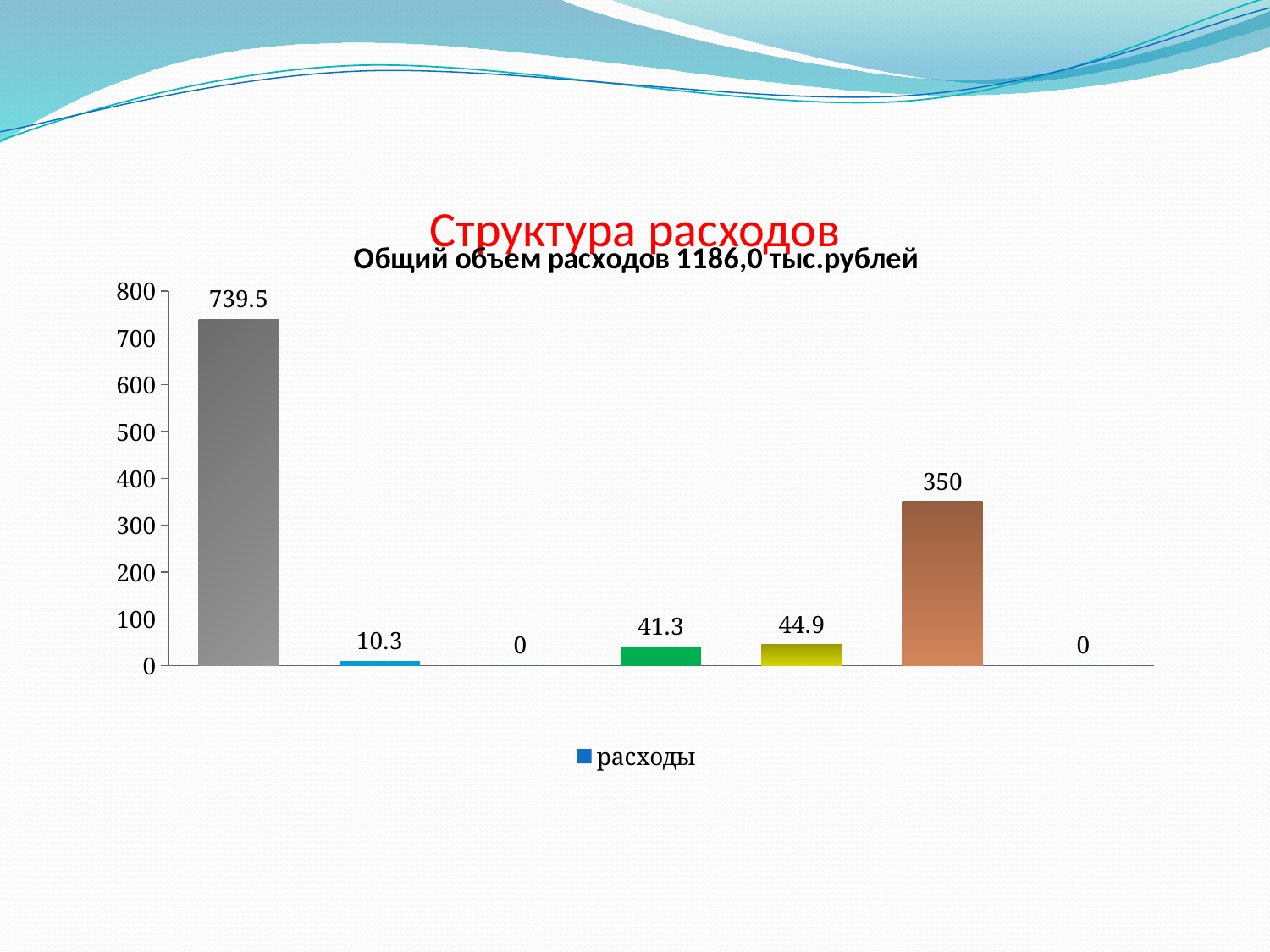
Which is larger, the fourth (green) bar or the fifth (yellow) bar? the fifth (yellow) bar, 44.9 What is the value of the fifth (yellow) bar? 44.9 What is the value of the first (grey) bar? 739.5 What is the difference between the first bar (739.5) and the sixth bar (350)? 389.5 What is the value of the second (blue) bar? 10.3 How many series does the legend list? 1 Which bar has the highest value? the first (grey) bar, 739.5 What kind of chart is shown on the slide? bar chart What is the chart's title? Общий объем расходов 1186,0 тыс.рублей What is the name of the series shown in the legend? расходы How many bars (categories) are plotted in the chart? 7 What is the value of the sixth (brown) bar? 350